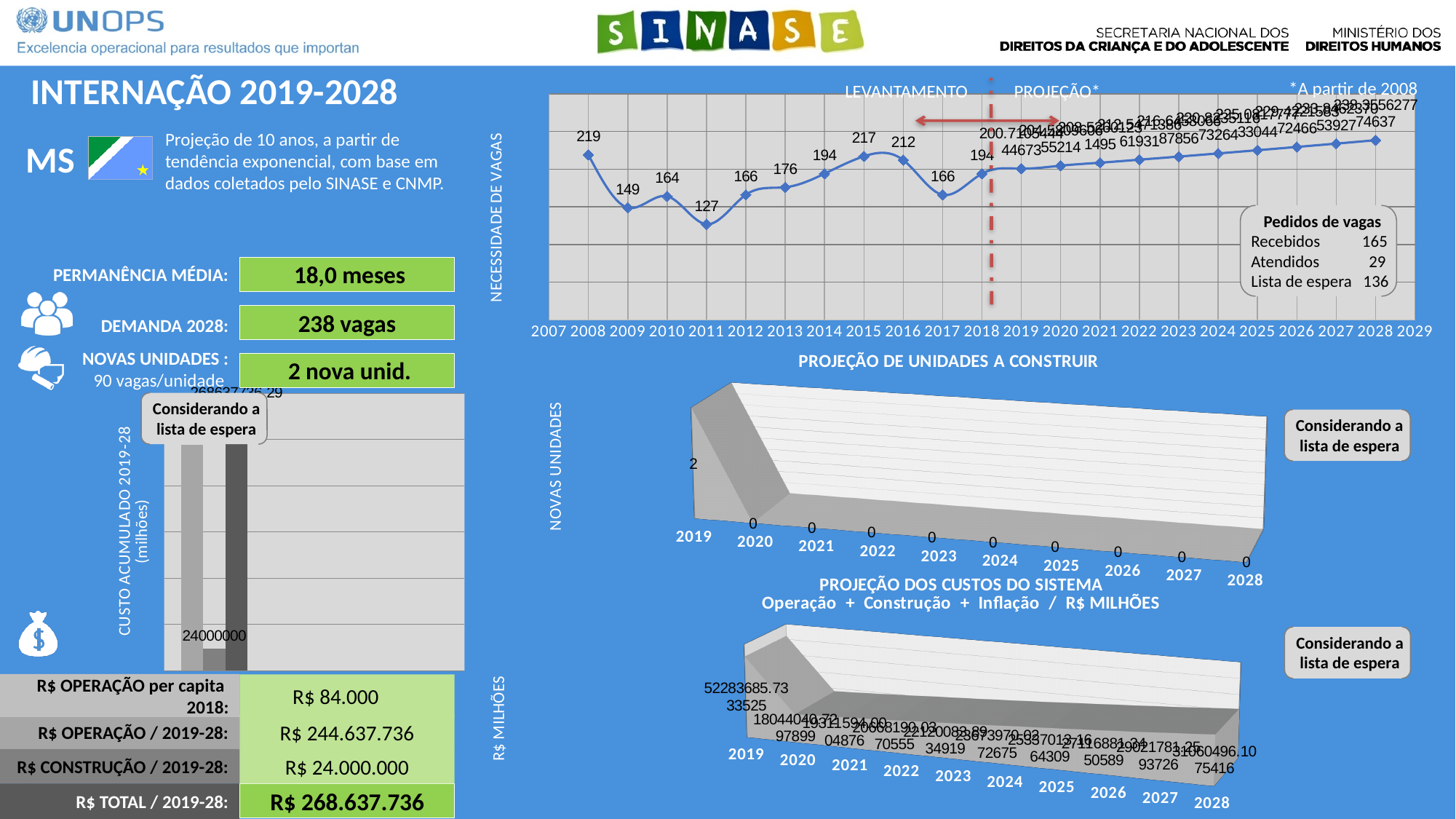
In the NECESSIDADE DE VAGAS line chart, what is the value for 2015? 217 In the PROJEÇÃO DE UNIDADES A CONSTRUIR chart, how many years are shown on the x axis? 10 In the NECESSIDADE DE VAGAS line chart, which is larger, the value for 2013 or the value for 2014? 2014 In the NECESSIDADE DE VAGAS chart, what do the labels on either side of the red dashed vertical line say? LEVANTAMENTO and PROJEÇÃO In the NECESSIDADE DE VAGAS line chart, which year in the LEVANTAMENTO period (2008-2018) has the highest value? 2008 What kind of chart is the NECESSIDADE DE VAGAS chart at the top right? line chart In the NECESSIDADE DE VAGAS line chart, what is the difference between the 2008 value and the 2011 value? 92 In the NECESSIDADE DE VAGAS line chart, do the values rise or fall from 2008 to 2011? fall What kind of chart is the PROJEÇÃO DOS CUSTOS DO SISTEMA chart at the bottom right? area chart In the PROJEÇÃO DE UNIDADES A CONSTRUIR chart, what is the value for 2019? 2 In the NECESSIDADE DE VAGAS line chart, what is the value for 2011? 127 In the NECESSIDADE DE VAGAS line chart, which year has the lowest value? 2011